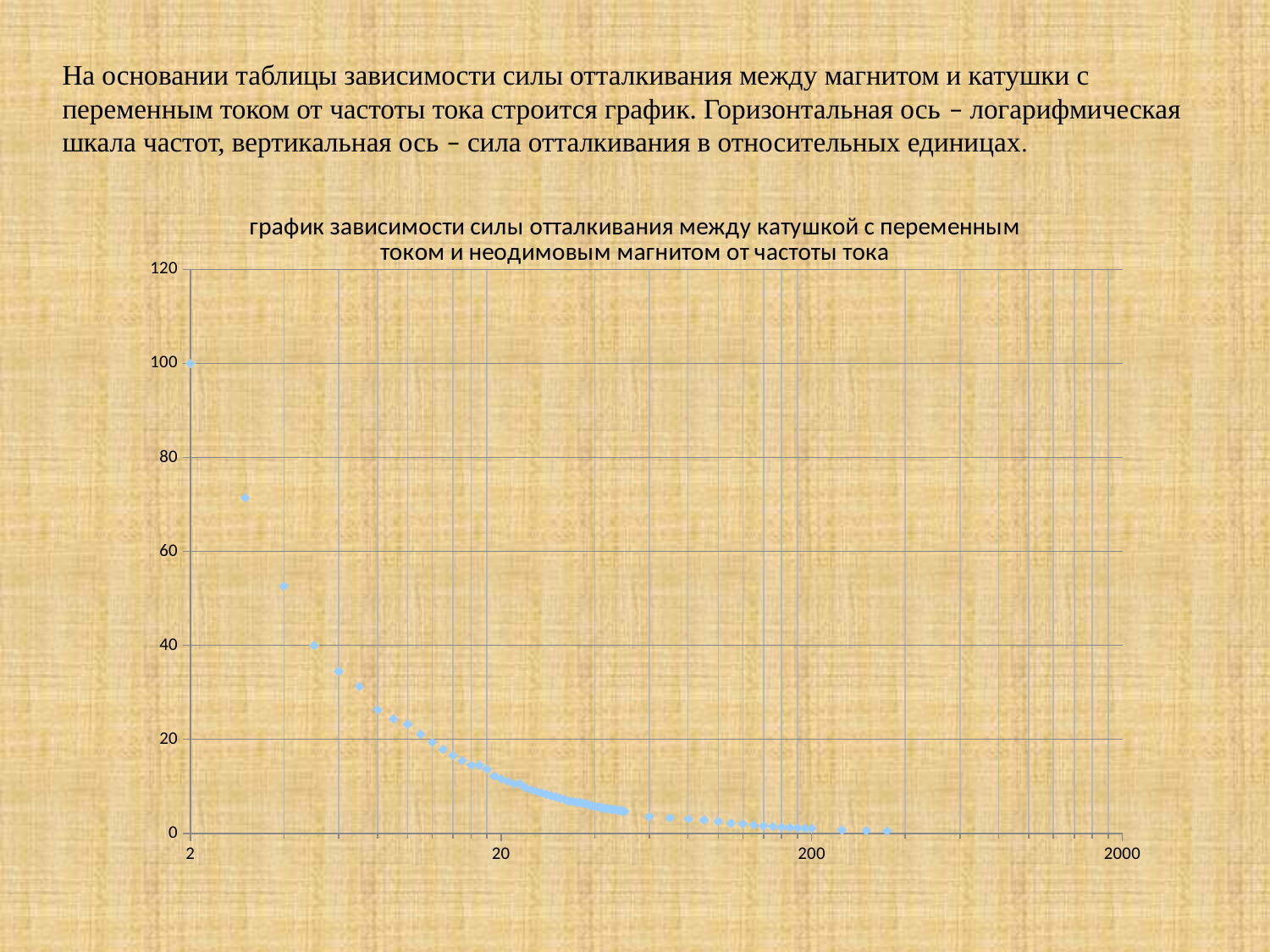
Do the plotted values rise or fall as the frequency increases along the x axis? fall What is the highest value shown on the vertical axis? 120 Is the value of the point at frequency 200 greater or less than 20? less What are the tick labels shown on the horizontal axis? 2, 20, 200, 2000 What is the value of the first point, at frequency 2 on the x axis? 100 What kind of chart is shown on the slide? scatter chart Is the value of the second plotted point (just after frequency 2) greater or less than 60? greater At which x-axis tick value does the highest plotted point occur? 2 Is the value of the point at frequency 20 greater or less than 20? less Which is larger: the value at frequency 2 or the value at frequency 200? the value at frequency 2